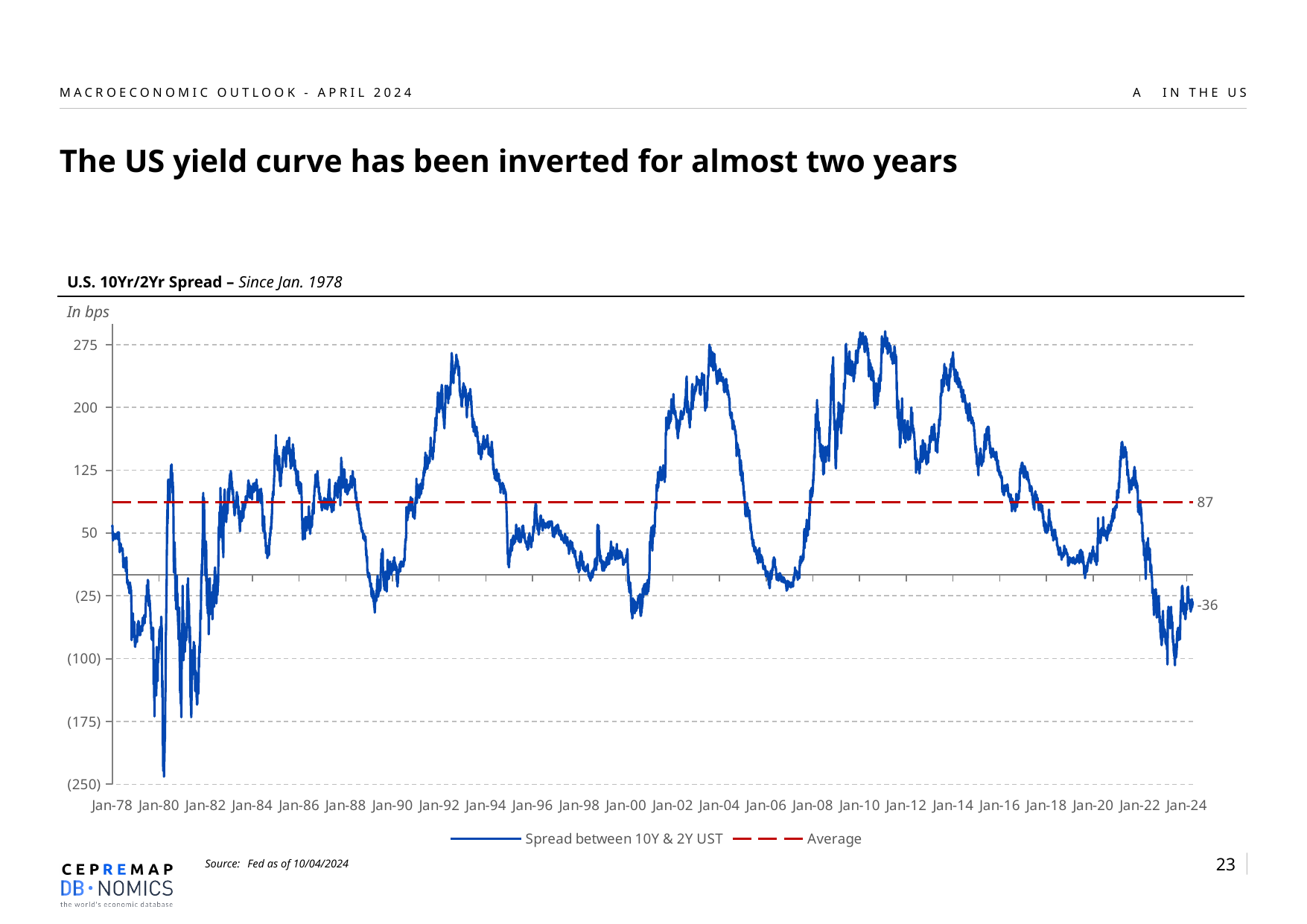
Is the lowest value of the spread around Jan-80 greater or less than (175)? less Is the spread value at Jan-98 greater or less than 125? less What is the difference between the Average value (87) and the latest spread value (-36)? 123 What is the title of the chart? U.S. 10Yr/2Yr Spread – Since Jan. 1978 Is the latest spread value (-36) above or below the Average line (87)? below How many series does the legend list? 2 Is the peak value of the spread around Jan-10 greater or less than 275? greater Between Jan-22 and Jan-24, does the spread rise or fall? fall In what units are the values on the chart expressed? In bps What value is labelled for the Average line? 87 What kind of chart is shown on the slide? line chart What is the latest value labelled for the spread between 10Y & 2Y UST? -36